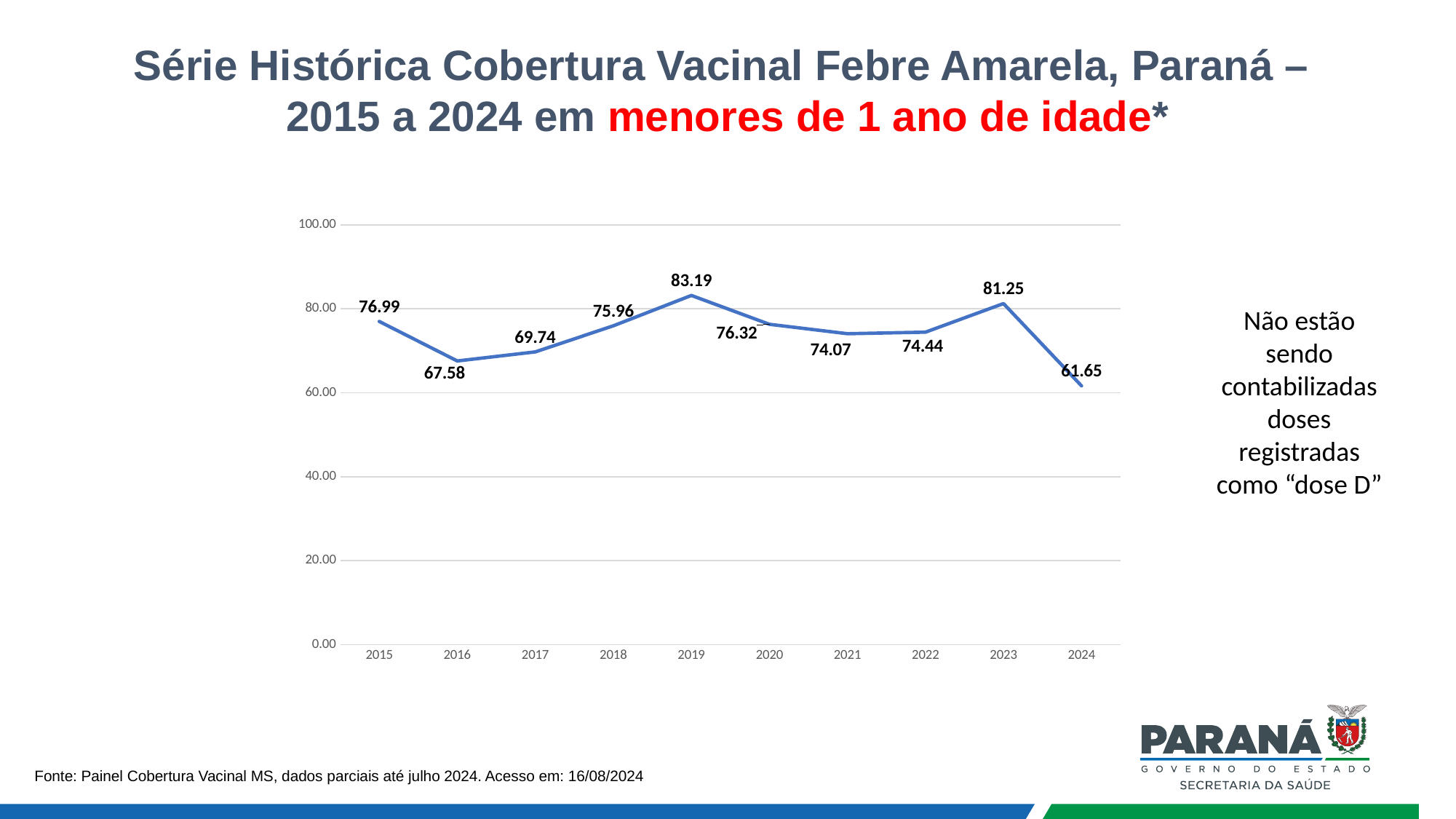
Is the value for 2023 greater or less than 80.00? greater What is the vaccine coverage value for 2019? 83.19 Which year has the lowest vaccine coverage value? 2024 What kind of chart is shown on the slide? line chart Which year has the highest vaccine coverage value? 2019 Does the value rise or fall from 2023 to 2024? fall What is the difference between the values for 2019 and 2024? 21.54 What is the difference between the values for 2023 and 2022? 6.81 Which is larger, the value for 2015 or the value for 2020? 2015 What is the vaccine coverage value for 2016? 67.58 How many years are plotted on the chart? 10 What is the vaccine coverage value for 2024? 61.65